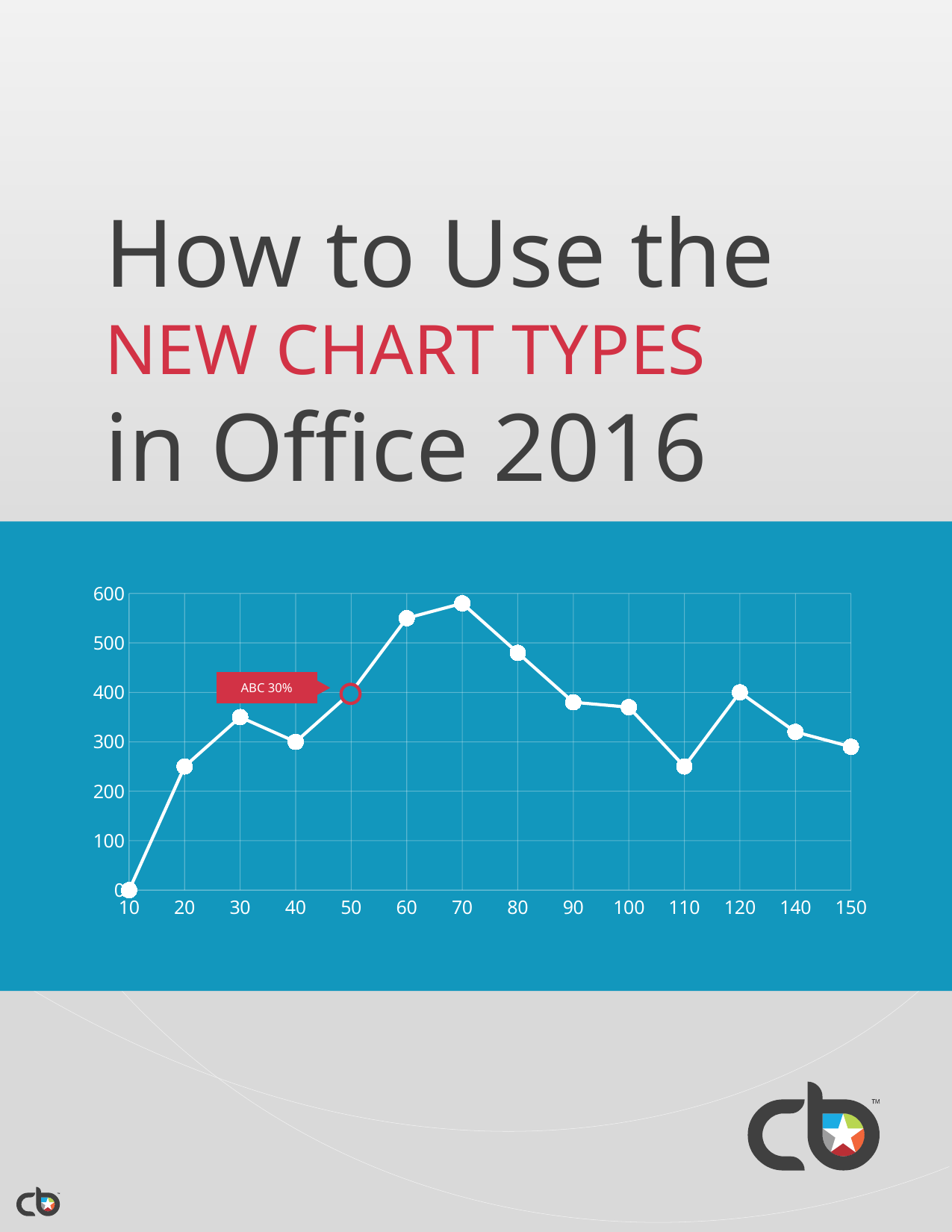
At which x-axis value does the line reach its highest point? 70 Is the value at x = 110 greater or less than 300? less What text is shown in the red callout label pointing at the circled point? ABC 30% How many data points are plotted on the line chart? 14 Which has the larger value, x = 60 or x = 110? 60 What is the value at x = 50, the point marked with the red circle? 400 What is the value at x = 120? 400 What is the value at x = 10? 0 Is the value at x = 70 greater or less than 500? greater What kind of chart is shown on the slide? line chart At which x-axis value does the line reach its lowest point? 10